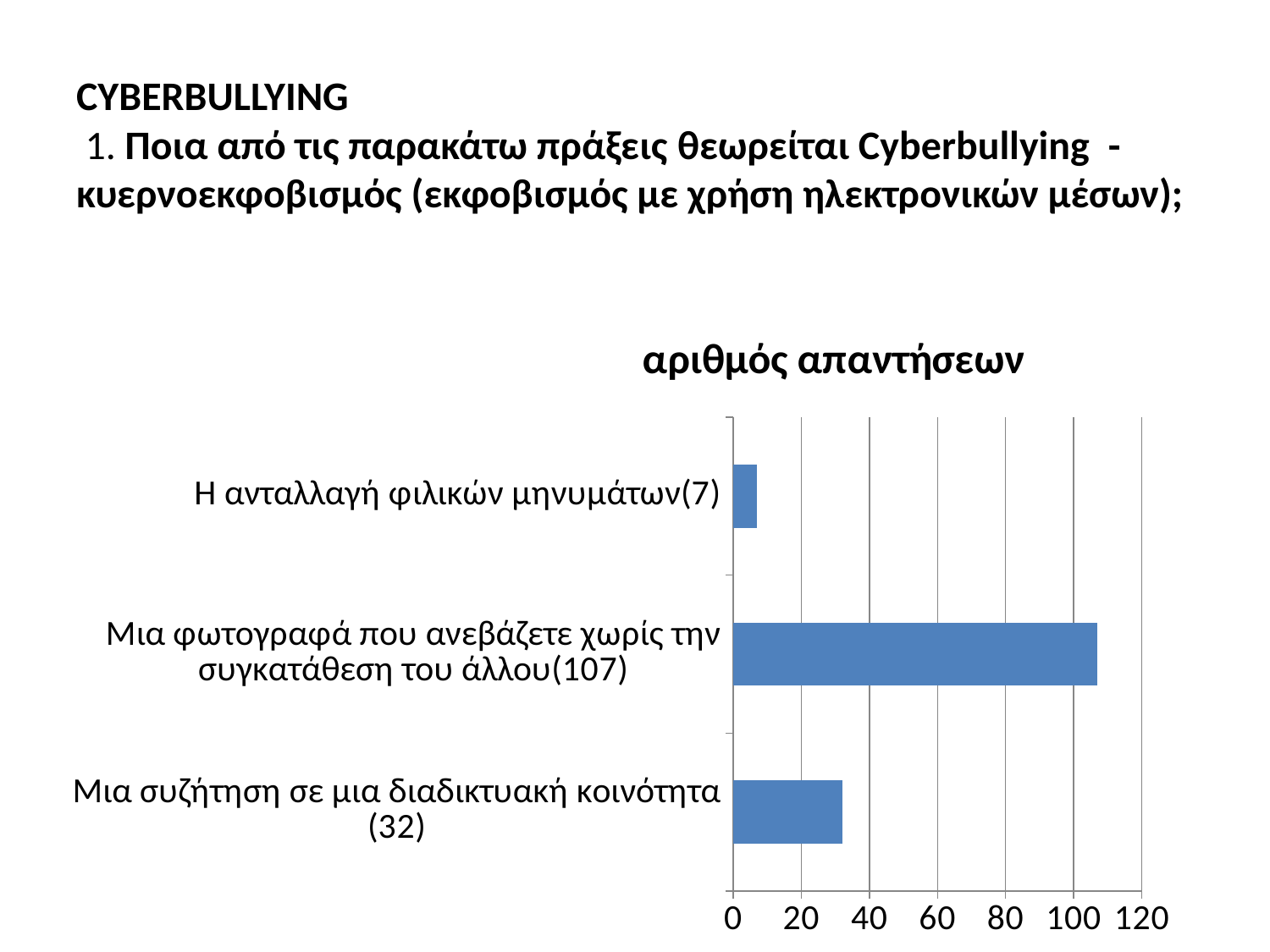
What kind of chart is shown on the slide? bar chart What is the difference between the number of answers for 'Μια φωτογραφά που ανεβάζετε χωρίς την συγκατάθεση του άλλου' and 'Μια συζήτηση σε μια διαδικτυακή κοινότητα'? 75 What is the title of the chart? αριθμός απαντήσεων What is the difference between the number of answers for 'Μια συζήτηση σε μια διαδικτυακή κοινότητα' and 'Η ανταλλαγή φιλικών μηνυμάτων'? 25 Which category has the highest number of answers? Μια φωτογραφά που ανεβάζετε χωρίς την συγκατάθεση του άλλου Is the value for 'Μια φωτογραφά που ανεβάζετε χωρίς την συγκατάθεση του άλλου' greater or less than 100? greater Which category has the lowest number of answers? Η ανταλλαγή φιλικών μηνυμάτων How many categories does the chart show? 3 What is the number of answers for 'Η ανταλλαγή φιλικών μηνυμάτων'? 7 What is the number of answers for 'Μια συζήτηση σε μια διαδικτυακή κοινότητα'? 32 What is the number of answers for 'Μια φωτογραφά που ανεβάζετε χωρίς την συγκατάθεση του άλλου'? 107 Which has more answers: 'Μια συζήτηση σε μια διαδικτυακή κοινότητα' or 'Η ανταλλαγή φιλικών μηνυμάτων'? Μια συζήτηση σε μια διαδικτυακή κοινότητα